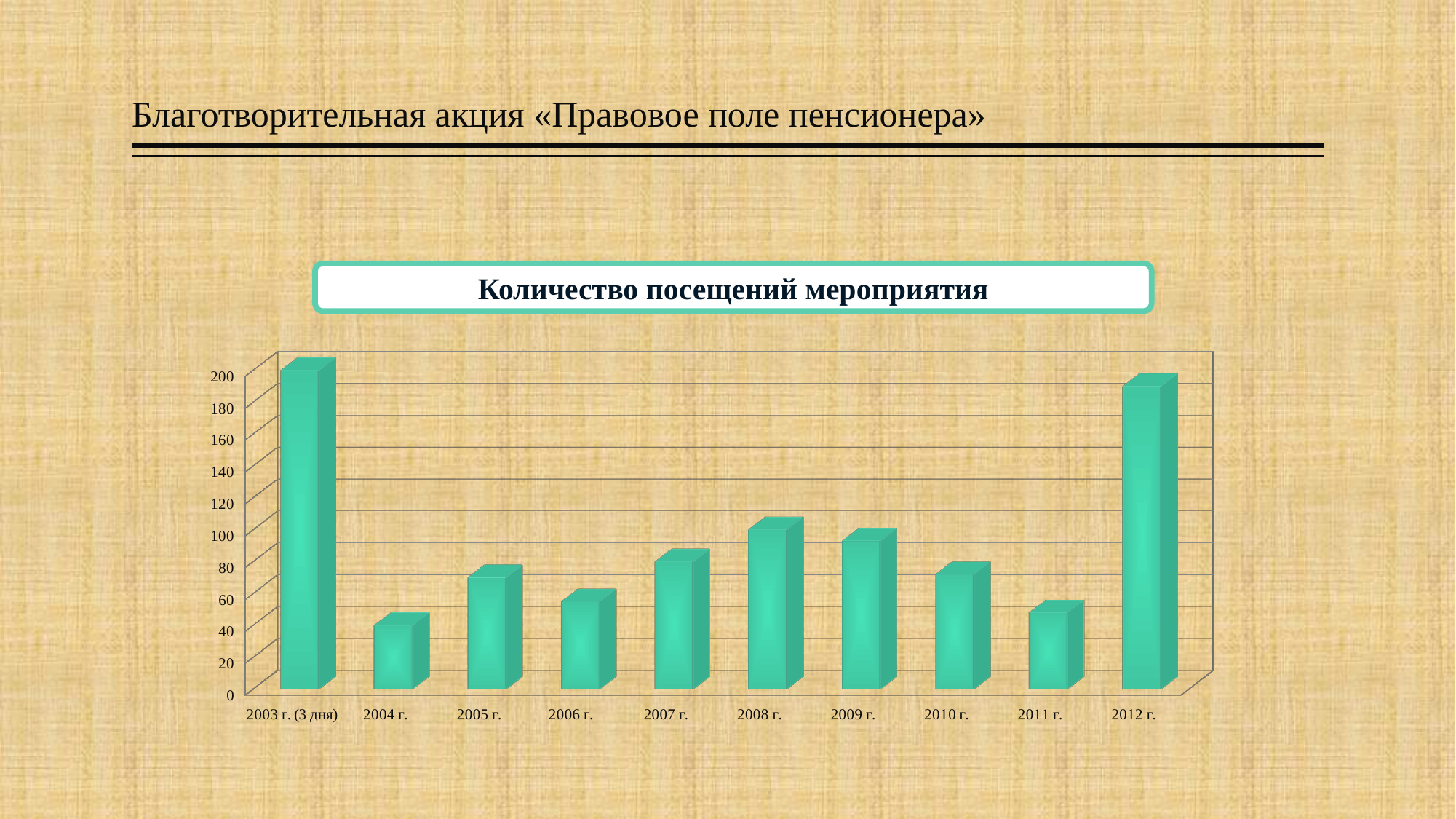
What kind of chart is shown on the slide? Bar chart Which year has the lowest number of visits in the chart? 2004 г. Is the value for 2004 г. greater or less than 60? less Which is larger, the value for 2012 г. or the value for 2010 г.? 2012 г. Is the value for 2003 г. (3 дня) greater or less than 140? greater Which year has the highest number of visits in the chart? 2003 г. (3 дня) Is the value for 2012 г. greater or less than 160? greater How many years (categories) are shown on the x axis of the chart? 10 What colour are the bars in the chart? Teal (green) Which is larger, the value for 2008 г. or the value for 2004 г.? 2008 г. What is the title of the chart? Количество посещений мероприятия